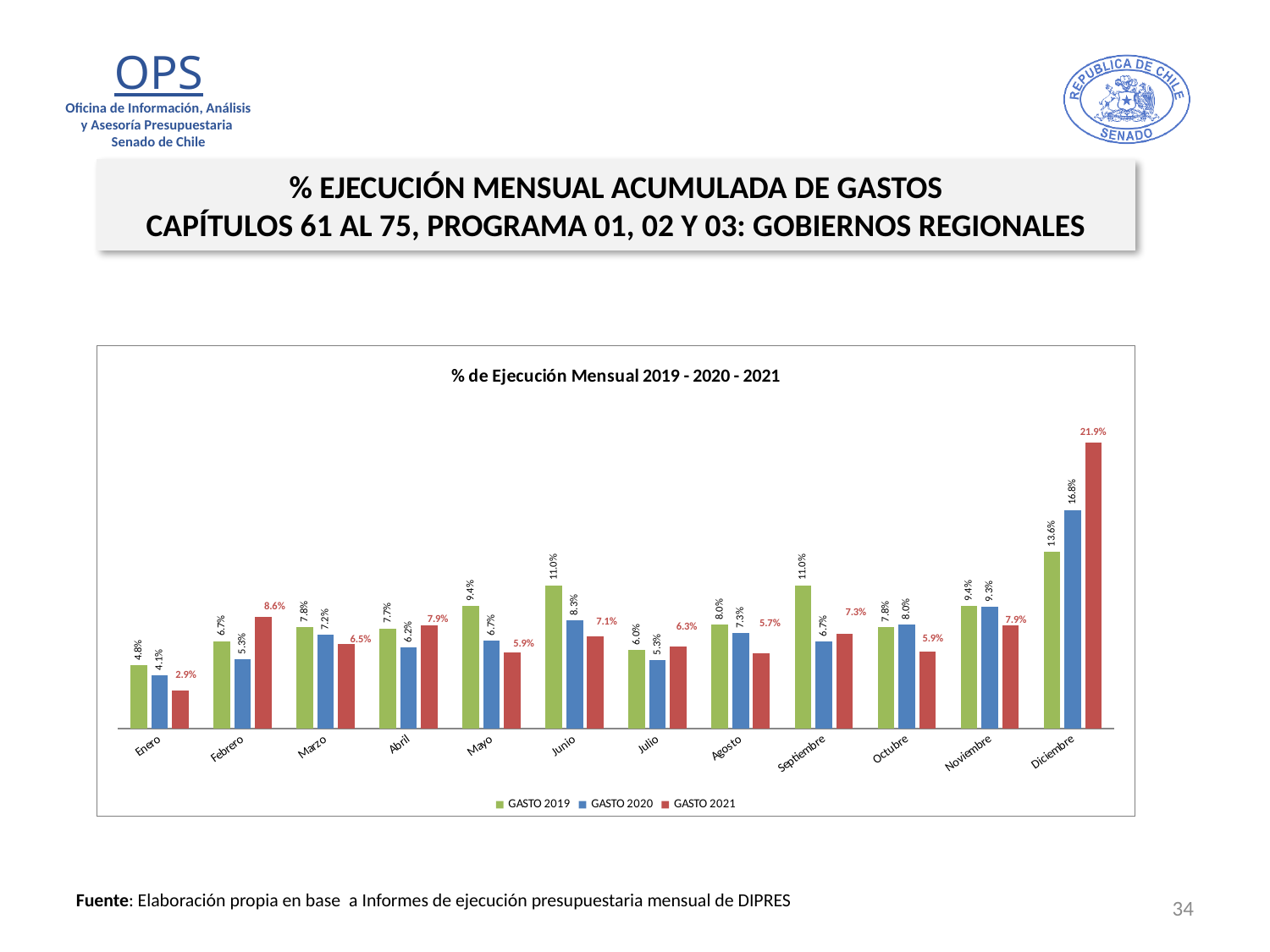
How many series does the legend list? 3 Which is larger in Mayo, GASTO 2019 or GASTO 2020? GASTO 2019 How many months are shown on the x axis? 12 What is the difference between GASTO 2021 and GASTO 2019 in Diciembre? 8.3% What is the title of the chart? % de Ejecución Mensual 2019 - 2020 - 2021 What is the value for GASTO 2019 in Enero? 4.8% What is the value for GASTO 2021 in Febrero? 8.6% Which month has the highest value for GASTO 2020? Diciembre What is the value for GASTO 2021 in Diciembre? 21.9% What is the value for GASTO 2020 in Junio? 8.3% What kind of chart is shown on the slide? Bar chart Which month has the lowest value for GASTO 2021? Enero